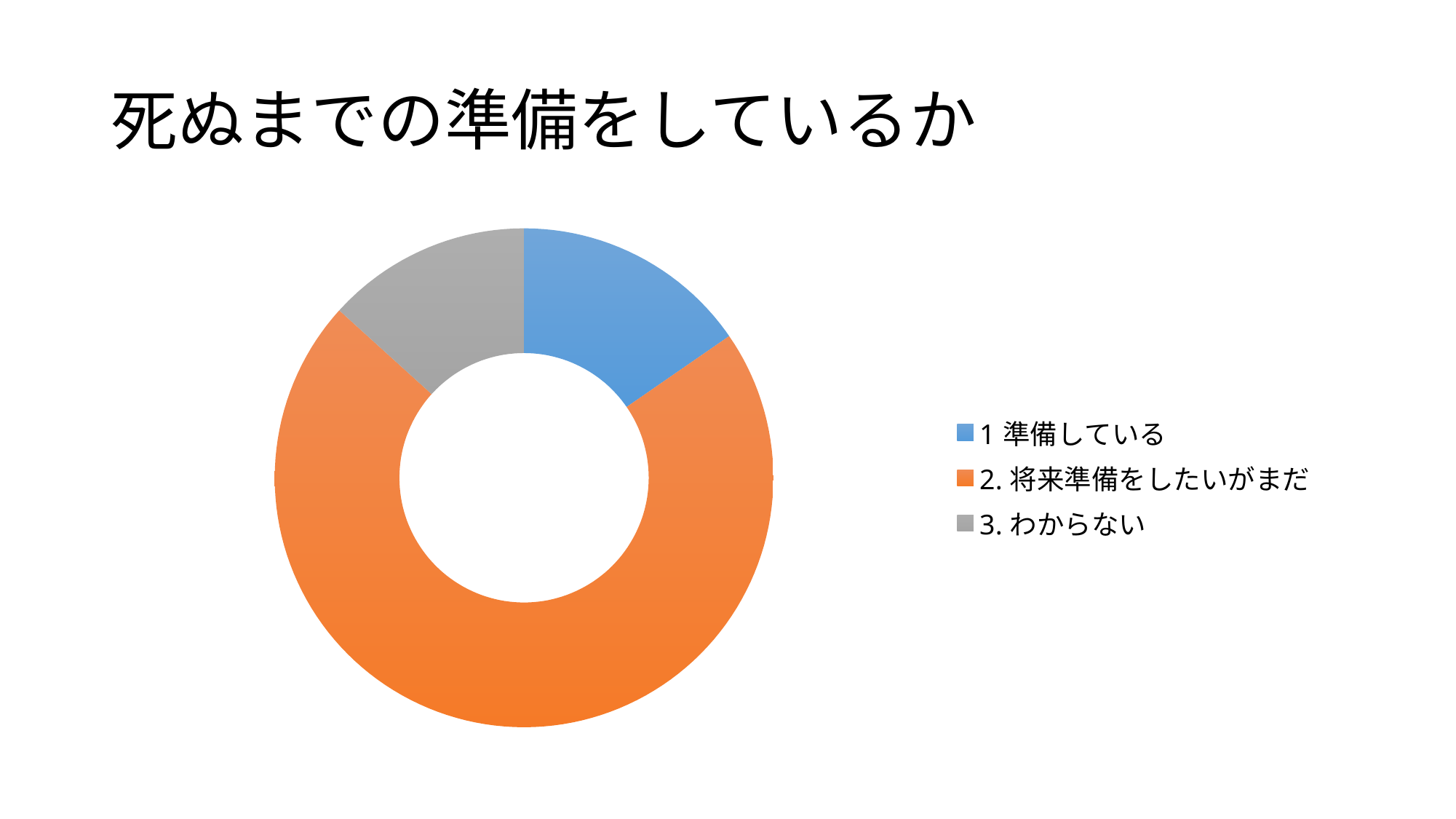
What kind of chart is shown on the slide? Doughnut (pie) chart Which category has the largest share of the chart? 2. 将来準備をしたいがまだ Which colour represents 3. わからない in the chart? Gray What is the title of the chart on the slide? 死ぬまでの準備をしているか Is the share for 2. 将来準備をしたいがまだ greater or less than half of the chart? greater Which is larger, the share for 3. わからない or the share for 2. 将来準備をしたいがまだ? 2. 将来準備をしたいがまだ Is the share for 1 準備している greater or less than half of the chart? less How many entries does the legend list? 3 How many categories does the chart show? 3 Which is larger, the share for 1 準備している or the share for 2. 将来準備をしたいがまだ? 2. 将来準備をしたいがまだ